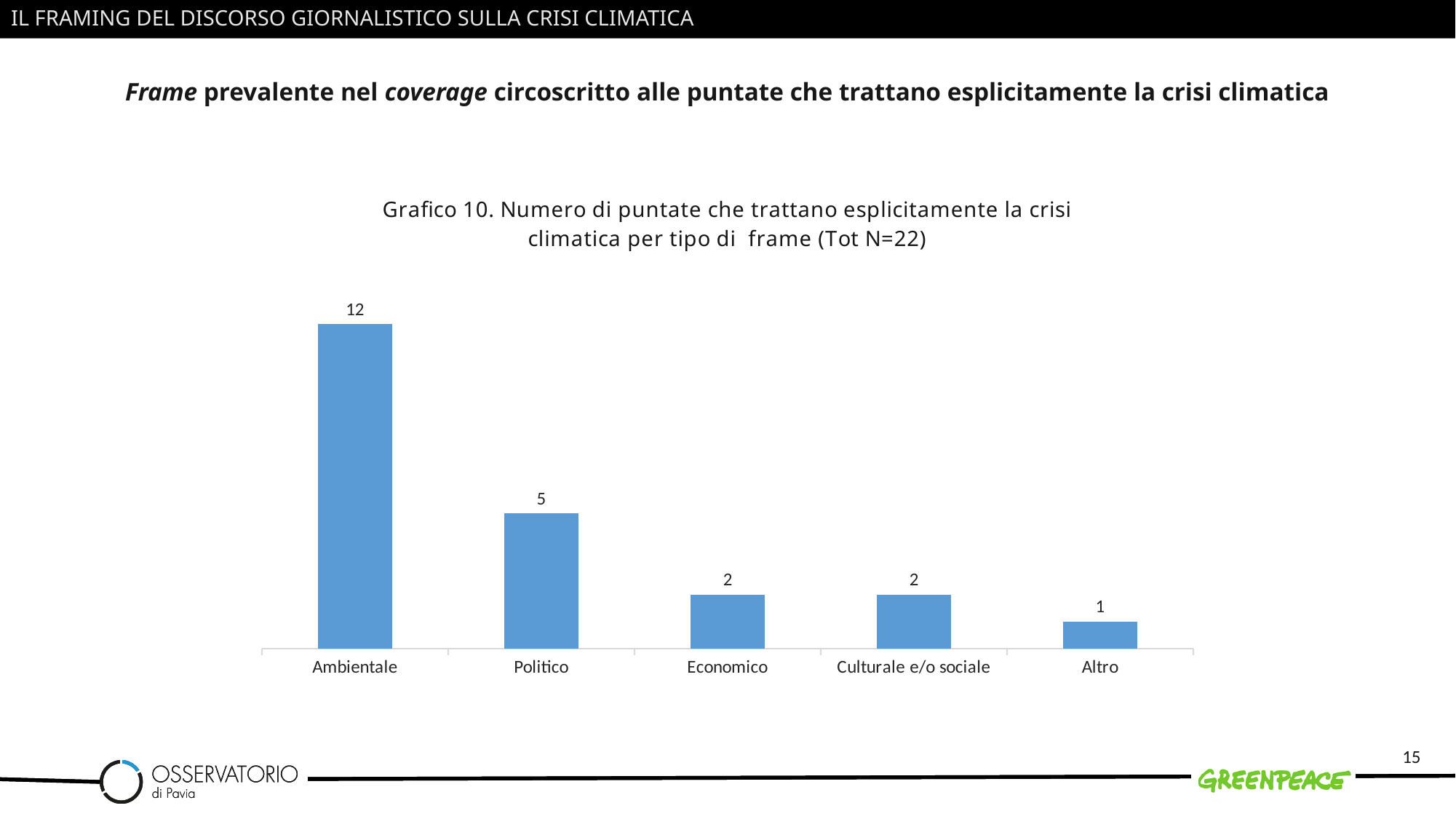
Which category has the highest value? Ambientale What kind of chart is this? Bar chart Do the values rise or fall from left to right along the x axis? Fall Which category has the lowest value? Altro Which is larger, the value for Politico or the value for Culturale e/o sociale? Politico What is the value for Politico? 5 What is the value for Ambientale? 12 How many categories are shown on the x axis? 5 What is the value for Economico? 2 What is the value for Altro? 1 What is the difference between the values for Ambientale and Politico? 7 What total N is stated in the chart title? 22